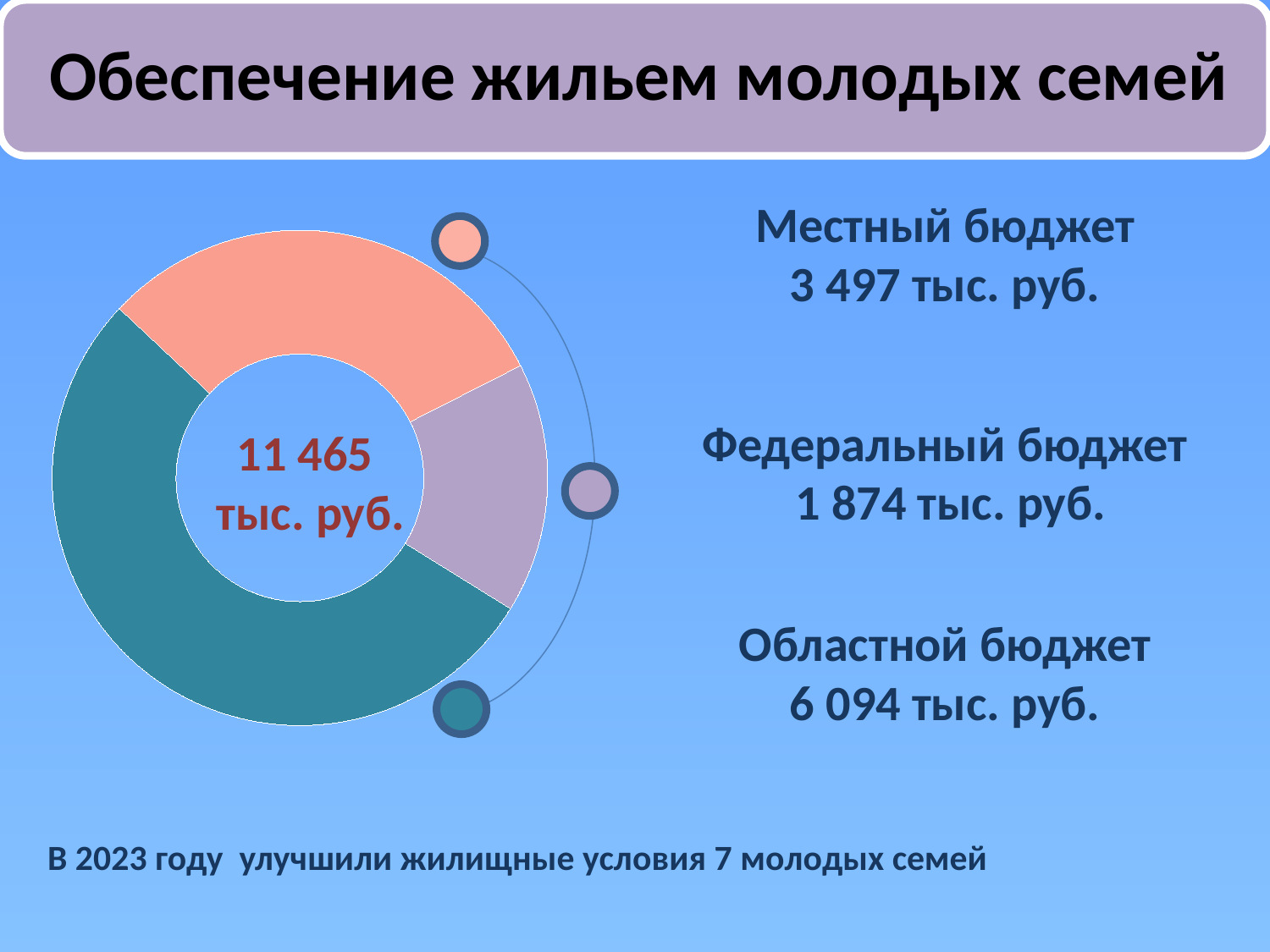
Which is larger, Местный бюджет or Федеральный бюджет? Местный бюджет What kind of chart is shown on the slide? Pie chart (donut) What is the value for Федеральный бюджет? 1 874 тыс. руб. What is the difference between Местный бюджет and Федеральный бюджет? 1 623 тыс. руб. What is the value for Областной бюджет? 6 094 тыс. руб. Which budget source has the largest value? Областной бюджет How many segments does the donut chart have? 3 What is the value for Местный бюджет? 3 497 тыс. руб. What total is shown in the centre of the donut chart? 11 465 тыс. руб. What is the title of the slide containing the chart? Обеспечение жильем молодых семей What is the difference between Областной бюджет and Местный бюджет? 2 597 тыс. руб. Which budget source has the smallest value? Федеральный бюджет